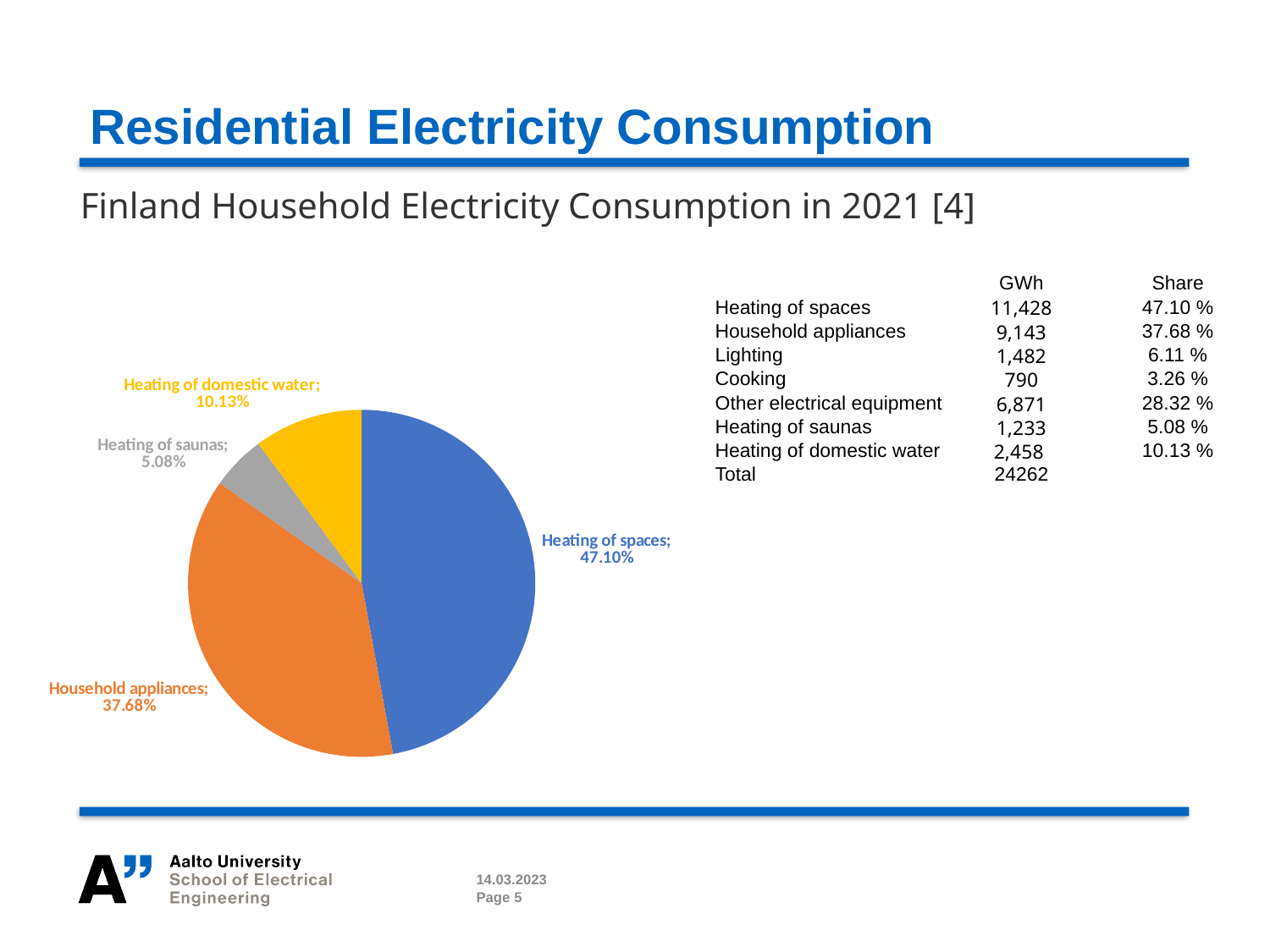
What share of the pie does Heating of domestic water have? 10.13% What kind of chart is shown on the slide? Pie chart What is the difference in percentage points between the Heating of spaces slice and the Household appliances slice? 9.42 What colour is the Household appliances slice in the pie chart? Orange What is the difference in percentage points between the Heating of domestic water slice and the Heating of saunas slice? 5.05 Which slice is larger: Heating of domestic water or Heating of saunas? Heating of domestic water What share of the pie does Heating of saunas have? 5.08% What share of the pie does Heating of spaces have? 47.10% Which slice of the pie chart is the smallest? Heating of saunas Which slice of the pie chart is the largest? Heating of spaces How many slices does the pie chart have? 4